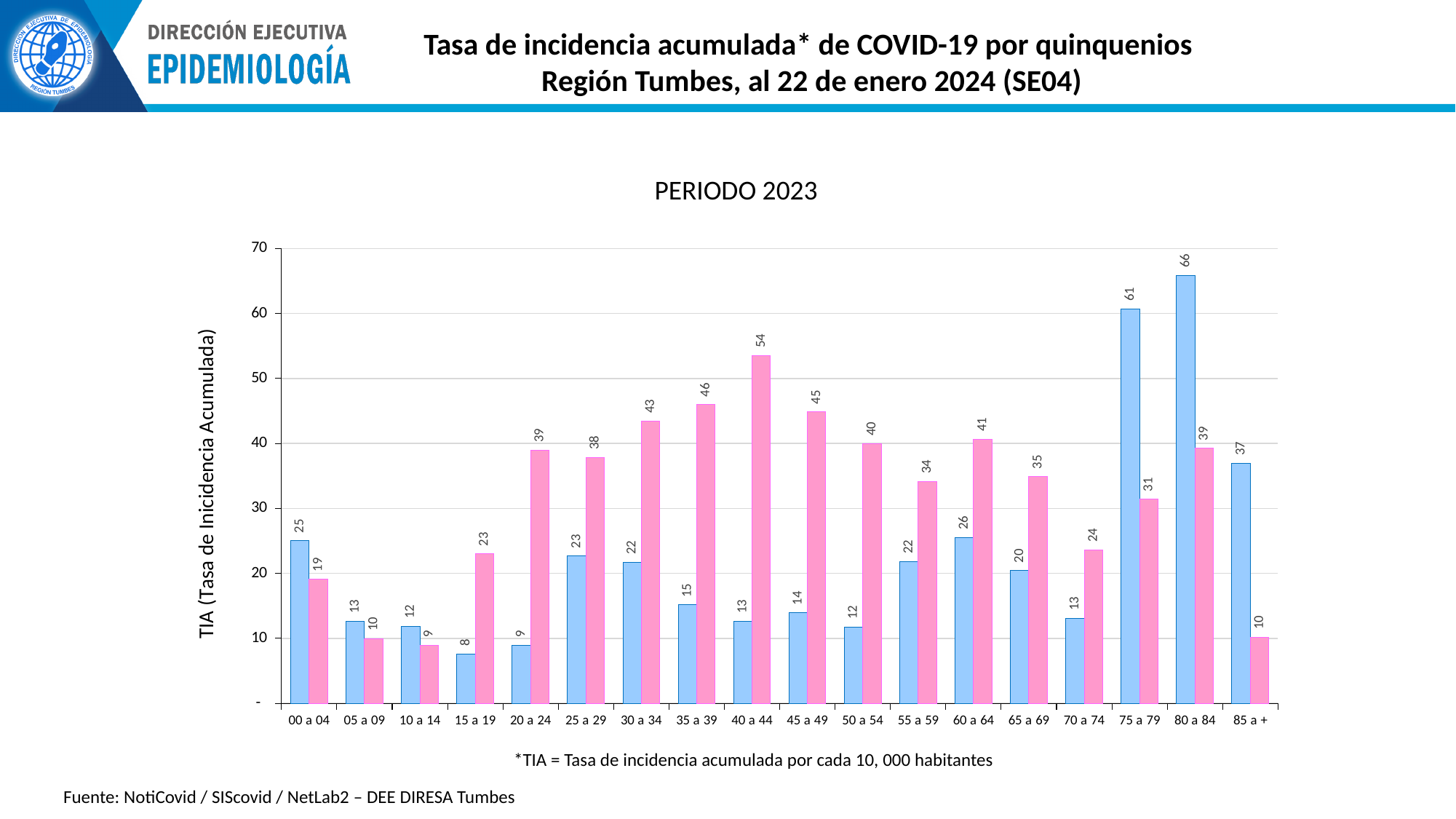
For the 85 a + age group, which bar is larger, blue or pink? blue Which age group has the highest pink bar? 40 a 44 How many age groups are shown on the x axis? 18 Which age group has the lowest blue bar? 15 a 19 What is the value of the blue bar for the 15 a 19 age group? 8 What type of chart is shown on the slide? bar chart What is the y-axis label of the chart? TIA (Tasa de Incidencia Acumulada) What is the difference between the pink bar and the blue bar for the 20 a 24 age group? 30 What is the value of the blue bar for the 80 a 84 age group? 66 What is the difference between the blue bar and the pink bar for the 75 a 79 age group? 30 What is the value of the pink bar for the 40 a 44 age group? 54 Which age group has the highest blue bar? 80 a 84